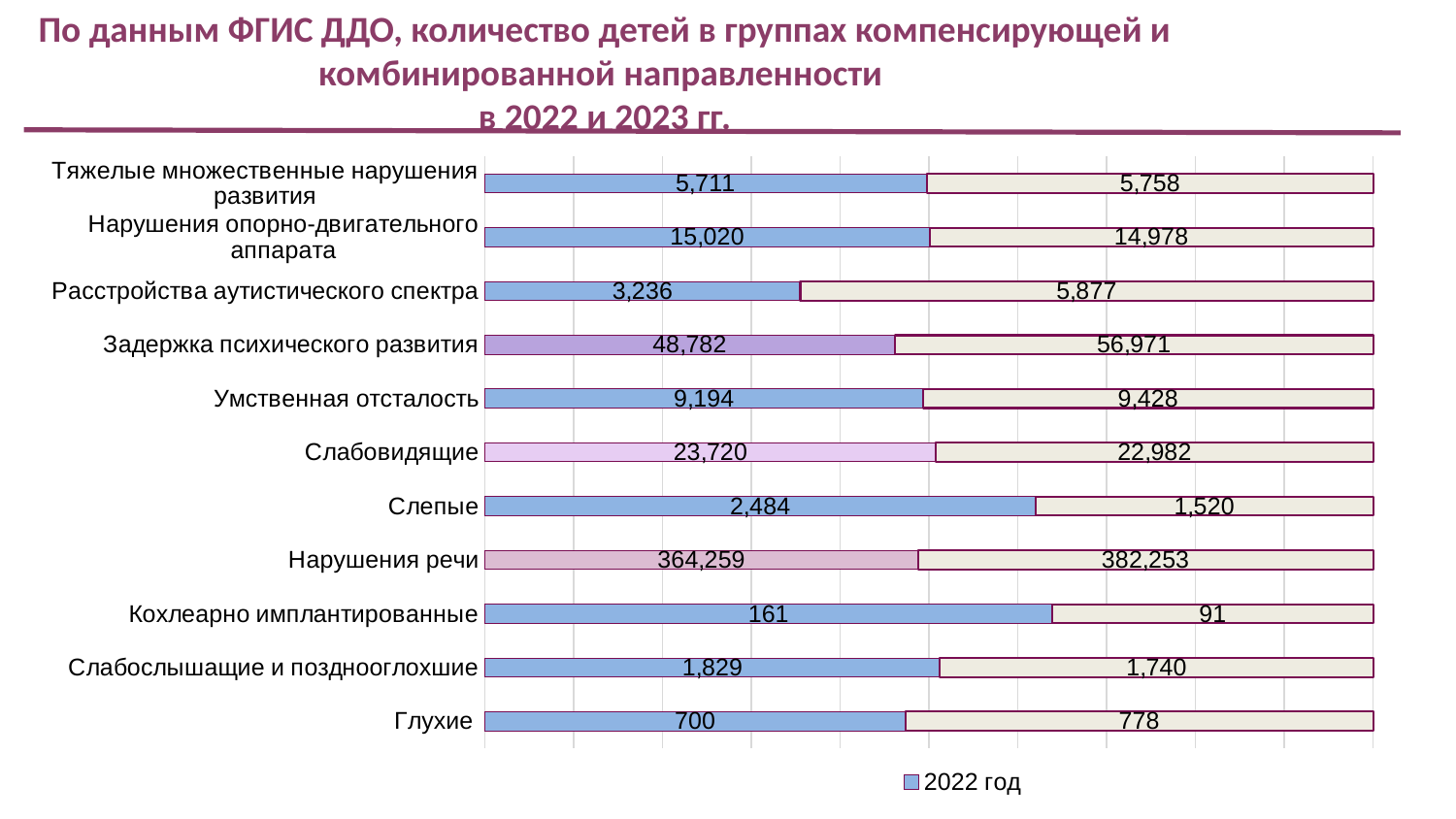
What is the total of the two segments for Глухие? 1,478 What is the 2022 год value for Глухие? 700 For Слепые, what is the difference between the 2022 год value and the right-hand (beige) segment value? 964 What is the 2022 год value for Нарушения речи? 364,259 For Расстройства аутистического спектра, how much larger is the right-hand (beige) segment value than the 2022 год value? 2,641 What value is printed on the right-hand (beige) segment for Расстройства аутистического спектра? 5,877 How many categories are shown on the chart? 11 Which category has the lowest 2022 год value? Кохлеарно имплантированные What kind of chart is shown on the slide? stacked bar chart For Задержка психического развития, which is larger: the 2022 год value or the right-hand (beige) segment value? the right-hand (beige) segment, 56,971 Which category has the highest 2022 год value? Нарушения речи How many series does the legend list? 1